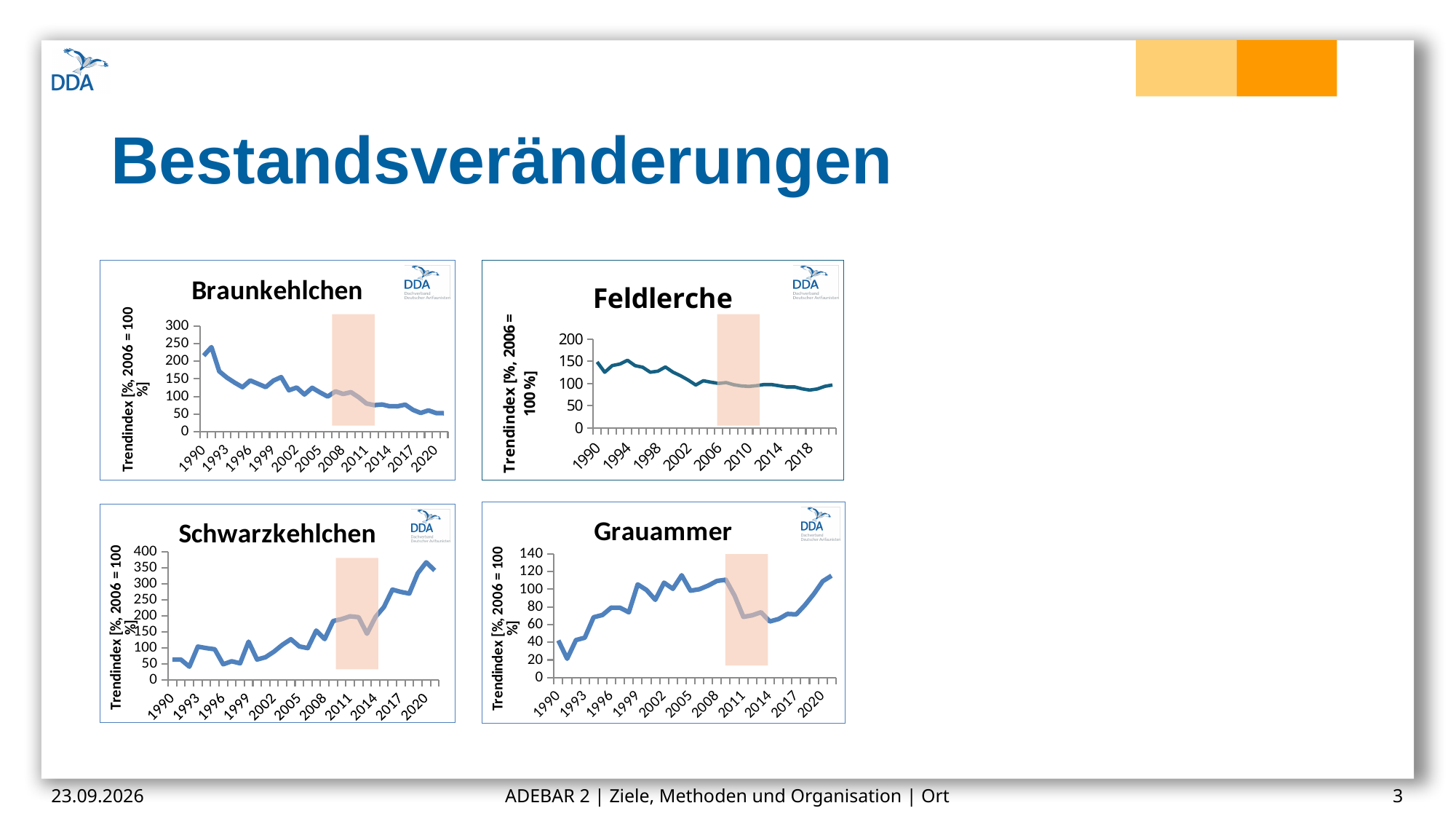
In the Braunkehlchen chart, is the value for 2020 greater or less than 100? less What kind of chart is the Braunkehlchen chart? line chart In the Schwarzkehlchen chart, do the values rise or fall from 1990 to 2020? rise In the Braunkehlchen chart, is the value for 1990 greater or less than 200? greater In the Grauammer chart, which is larger, the value for 1990 or the value for 2020? 2020 What is the y-axis label of the Schwarzkehlchen chart? Trendindex [%, 2006 = 100 %] In the Schwarzkehlchen chart, is the value for 2020 greater or less than 300? greater In the Feldlerche chart, do the values rise or fall overall from 1990 to 2018? fall How many charts are shown on the slide? 4 In the Braunkehlchen chart, do the values rise or fall from 1990 to 2020? fall